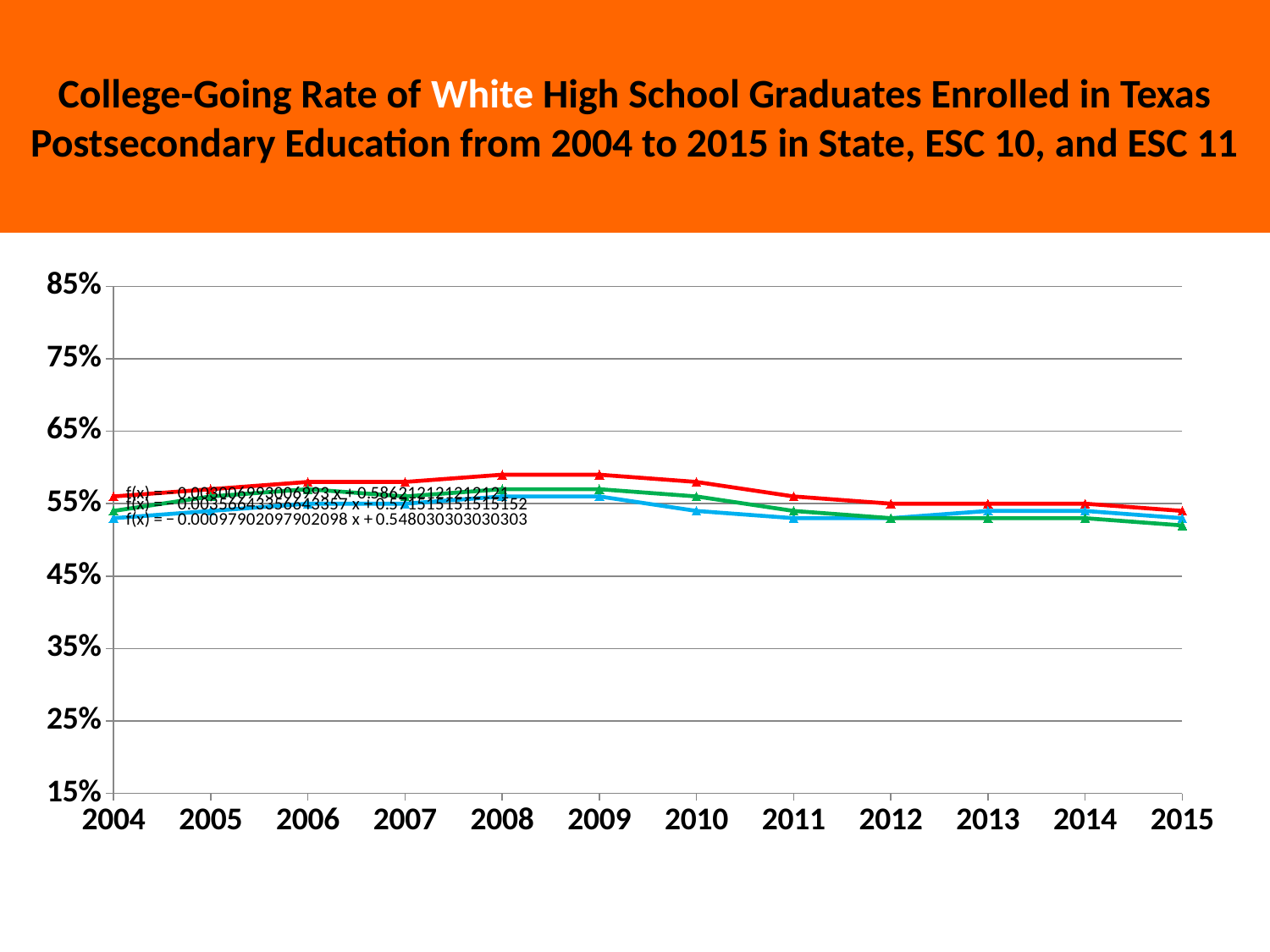
What is the first year shown on the x axis? 2004 How many years are shown along the x axis of the chart? 12 Is the value of the blue line in 2015 greater or less than 55%? less How many lines are plotted on the chart? 3 In 2010, which line has the higher value, the red line or the blue line? red line Is the value of the red line in 2004 greater or less than 45%? greater Is the value of the green line in 2015 greater or less than 55%? less In 2015, which line has the higher value, the red line or the green line? red line Does the red line rise or fall between 2009 and 2012? fall What is the highest value labelled on the y axis? 85% What kind of chart is shown on the slide? line chart